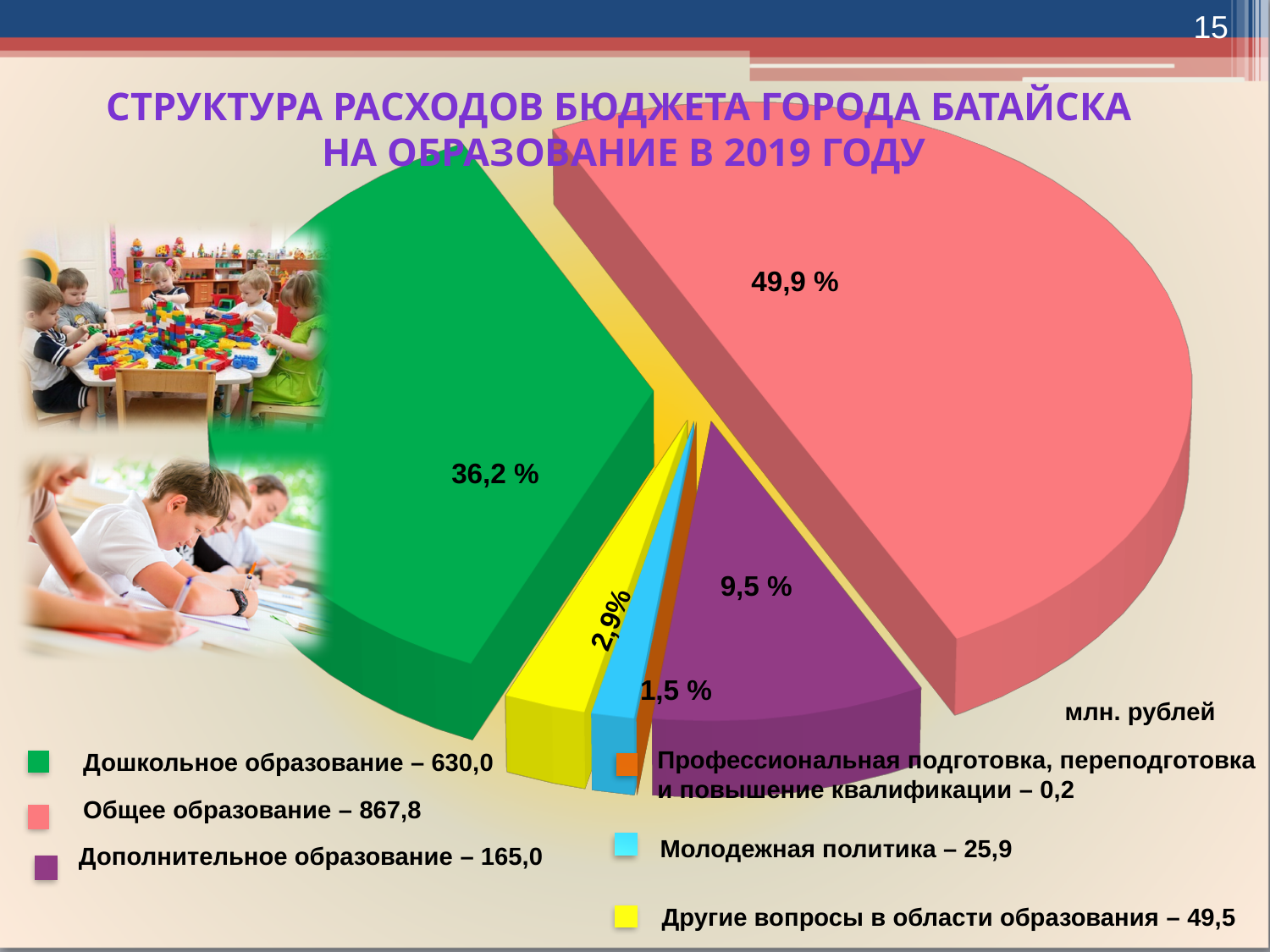
What is the value for Профессиональная подготовка, переподготовка и повышение квалификации? 0,2 What type of chart is shown on the slide? Pie chart What is the value for Дошкольное образование in the legend? 630,0 What is the value for Общее образование in the legend? 867,8 How many categories does the pie chart have? 6 Which category has the smallest value? Профессиональная подготовка, переподготовка и повышение квалификации What share of the pie does Общее образование take? 49,9 % Which is larger, Дополнительное образование or Другие вопросы в области образования? Дополнительное образование What is the value for Молодежная политика in the legend? 25,9 What is the difference between Другие вопросы в области образования and Молодежная политика? 23,6 What is the difference between Общее образование and Дошкольное образование? 237,8 Which category has the largest share of the budget? Общее образование